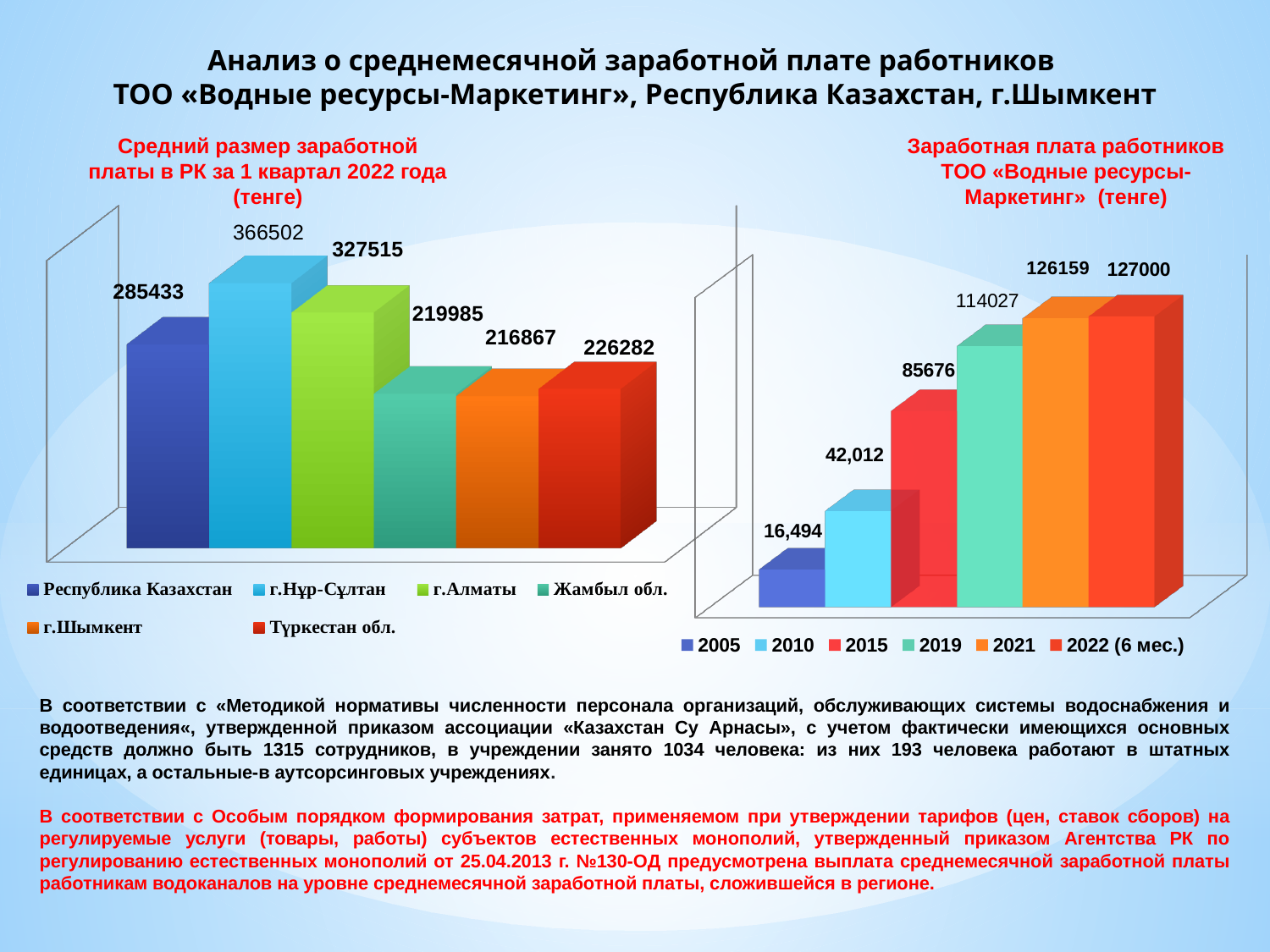
In the right chart (Заработная плата работников ТОО «Водные ресурсы-Маркетинг»), do the values rise or fall from 2005 to 2022 (6 мес.)? Rise In the right chart (Заработная плата работников ТОО «Водные ресурсы-Маркетинг»), which year has the lowest value? 2005 In the left chart (Средний размер заработной платы в РК за 1 квартал 2022 года), which category has the highest value? г.Нұр-Сұлтан In the left chart (Средний размер заработной платы в РК за 1 квартал 2022 года), how many categories are shown? 6 In the left chart (Средний размер заработной платы в РК за 1 квартал 2022 года), what is the value for г.Нұр-Сұлтан? 366502 What kind of chart is the right chart (Заработная плата работников ТОО «Водные ресурсы-Маркетинг»)? Bar chart In the right chart (Заработная плата работников ТОО «Водные ресурсы-Маркетинг»), is the value for 2019 larger than the value for 2015? Yes In the left chart (Средний размер заработной платы в РК за 1 квартал 2022 года), which category has the lowest value? г.Шымкент In the left chart (Средний размер заработной платы в РК за 1 квартал 2022 года), what is the difference between the values for г.Нұр-Сұлтан and г.Алматы? 38987 In the right chart (Заработная плата работников ТОО «Водные ресурсы-Маркетинг»), what is the value for 2005? 16,494 In the right chart (Заработная плата работников ТОО «Водные ресурсы-Маркетинг»), what is the value for 2015? 85676 In the left chart (Средний размер заработной платы в РК за 1 квартал 2022 года), what is the value for г.Шымкент? 216867